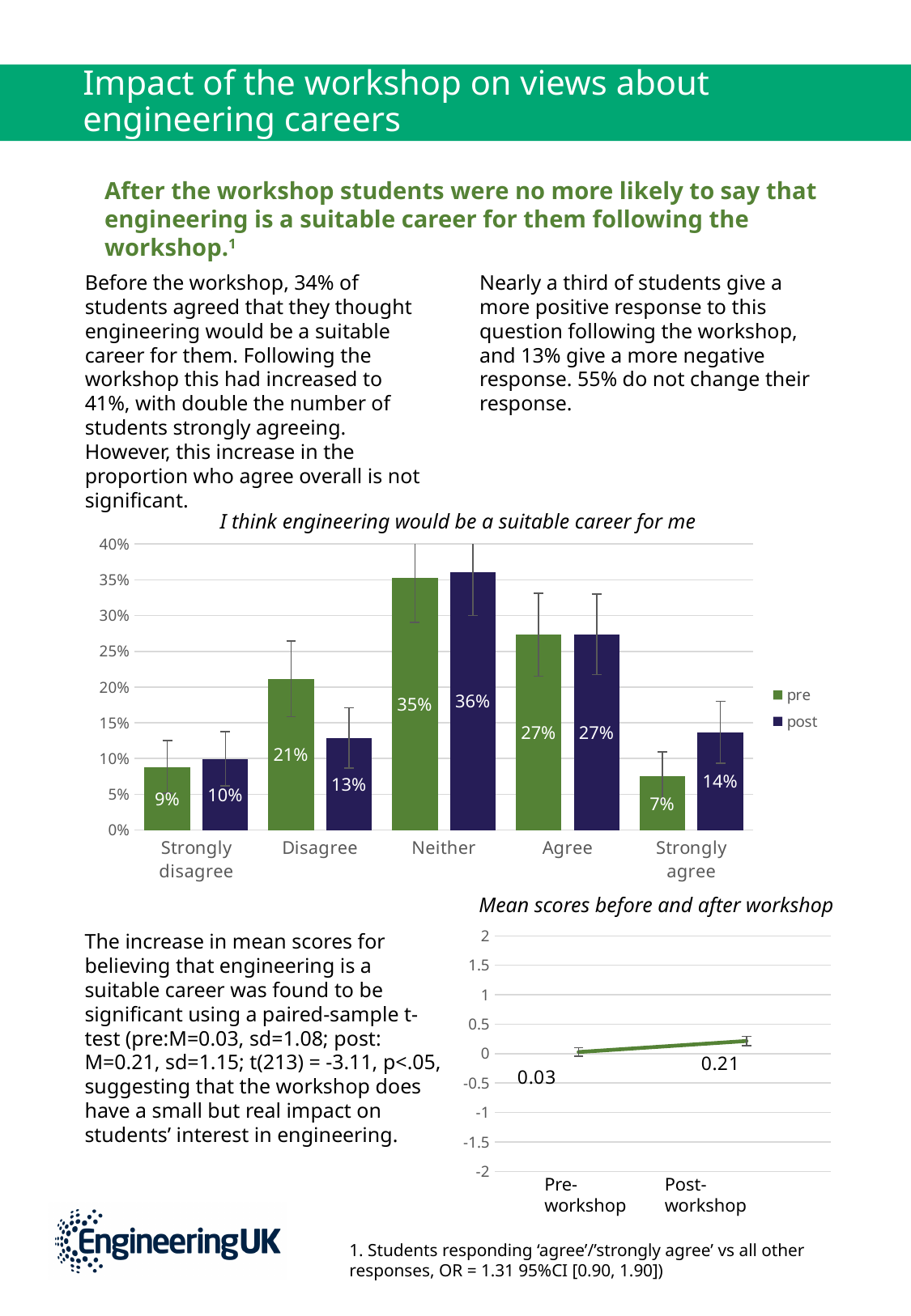
In the chart titled 'I think engineering would be a suitable career for me', which category has the lowest pre value? Strongly agree In the chart titled 'Mean scores before and after workshop', what is the value for Post-workshop? 0.21 In the chart titled 'I think engineering would be a suitable career for me', what is the pre value for Disagree? 21% In the chart titled 'I think engineering would be a suitable career for me', which category has the highest post value? Neither In the chart titled 'I think engineering would be a suitable career for me', what is the post value for Strongly agree? 14% In the chart titled 'I think engineering would be a suitable career for me', which is larger for Disagree, the pre value or the post value? pre In the chart titled 'I think engineering would be a suitable career for me', what is the difference between the pre and post values for Strongly agree? 7% In the chart titled 'Mean scores before and after workshop', do the values rise or fall from Pre-workshop to Post-workshop? rise In the chart titled 'I think engineering would be a suitable career for me', how many categories are shown on the x axis? 5 In the chart titled 'I think engineering would be a suitable career for me', which colour represents the post series? dark navy blue In the chart titled 'I think engineering would be a suitable career for me', how many series does the legend list? 2 What kind of chart is 'I think engineering would be a suitable career for me'? bar chart